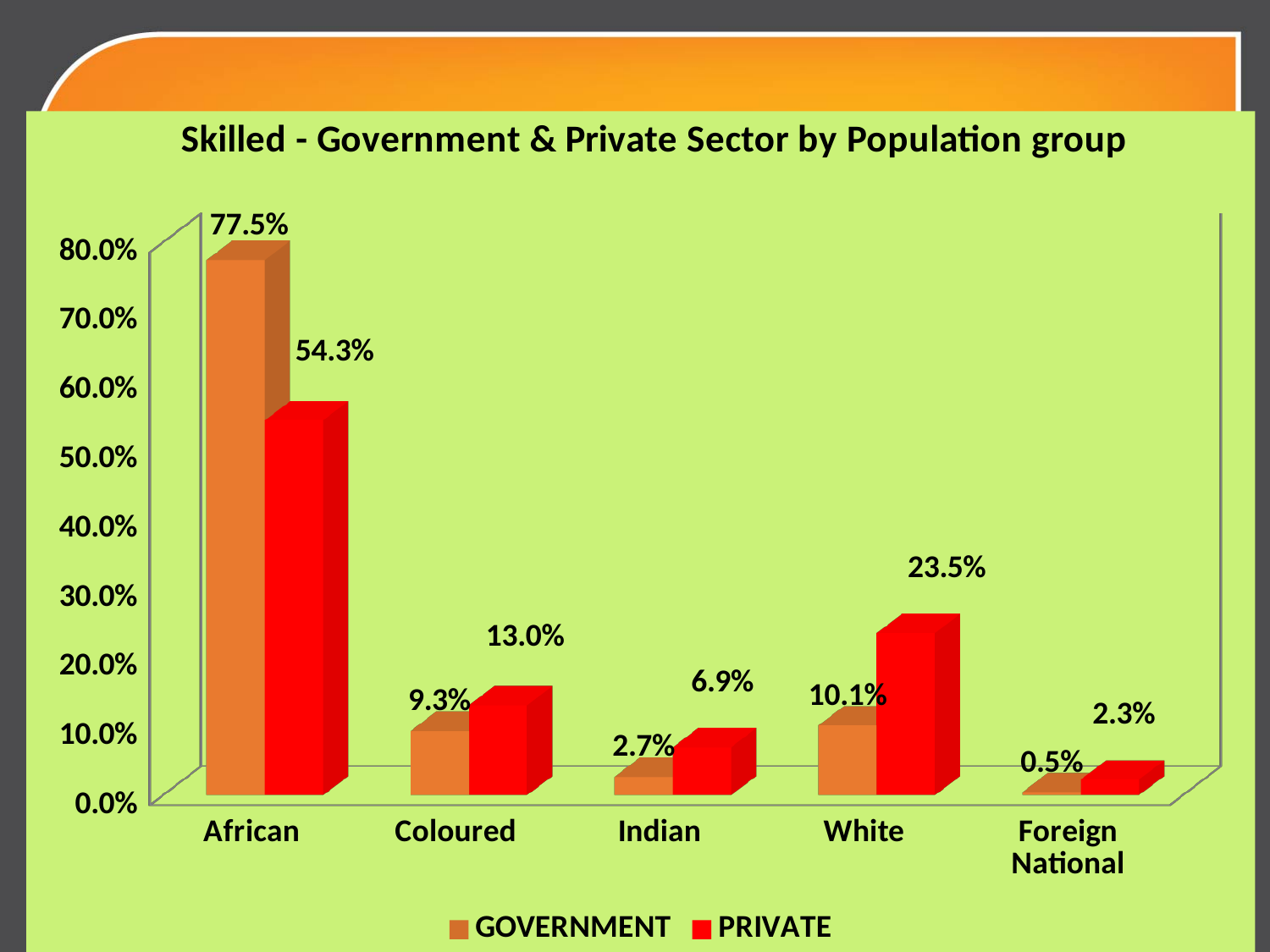
How many series does the legend list? 2 What is the GOVERNMENT value for African? 77.5% Which population group has the highest PRIVATE value? African Which is larger for White: the GOVERNMENT value or the PRIVATE value? PRIVATE Which population group has the lowest GOVERNMENT value? Foreign National What is the title of the chart? Skilled - Government & Private Sector by Population group What is the difference between the GOVERNMENT and PRIVATE values for African? 23.2% What is the GOVERNMENT value for Foreign National? 0.5% What kind of chart is shown on the slide? Bar chart How many population groups are shown on the x axis? 5 What is the PRIVATE value for Indian? 6.9% What is the PRIVATE value for White? 23.5%